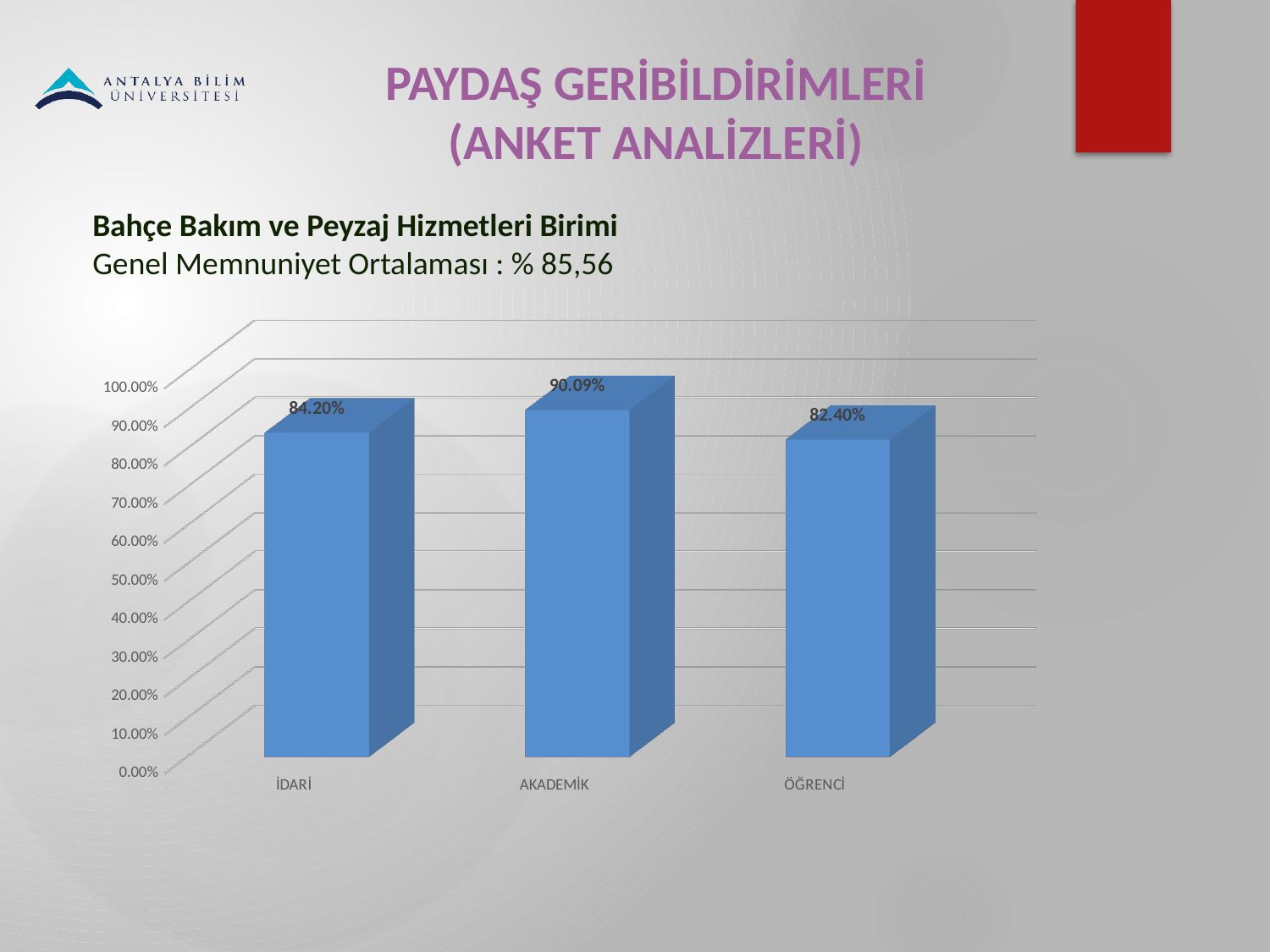
Which category has the highest value? AKADEMİK What is the value for AKADEMİK? 90.09% What is the difference between the values for AKADEMİK and İDARİ? 5.89% What is the value for İDARİ? 84.20% What is the overall satisfaction average (Genel Memnuniyet Ortalaması) stated above the chart? % 85,56 What is the difference between the values for İDARİ and ÖĞRENCİ? 1.80% How many categories are shown on the x axis? 3 What is the value for ÖĞRENCİ? 82.40% Is the value for AKADEMİK greater or less than 90.00%? greater What kind of chart is shown on the slide? bar chart Which is larger, the value for İDARİ or the value for ÖĞRENCİ? İDARİ Which category has the lowest value? ÖĞRENCİ